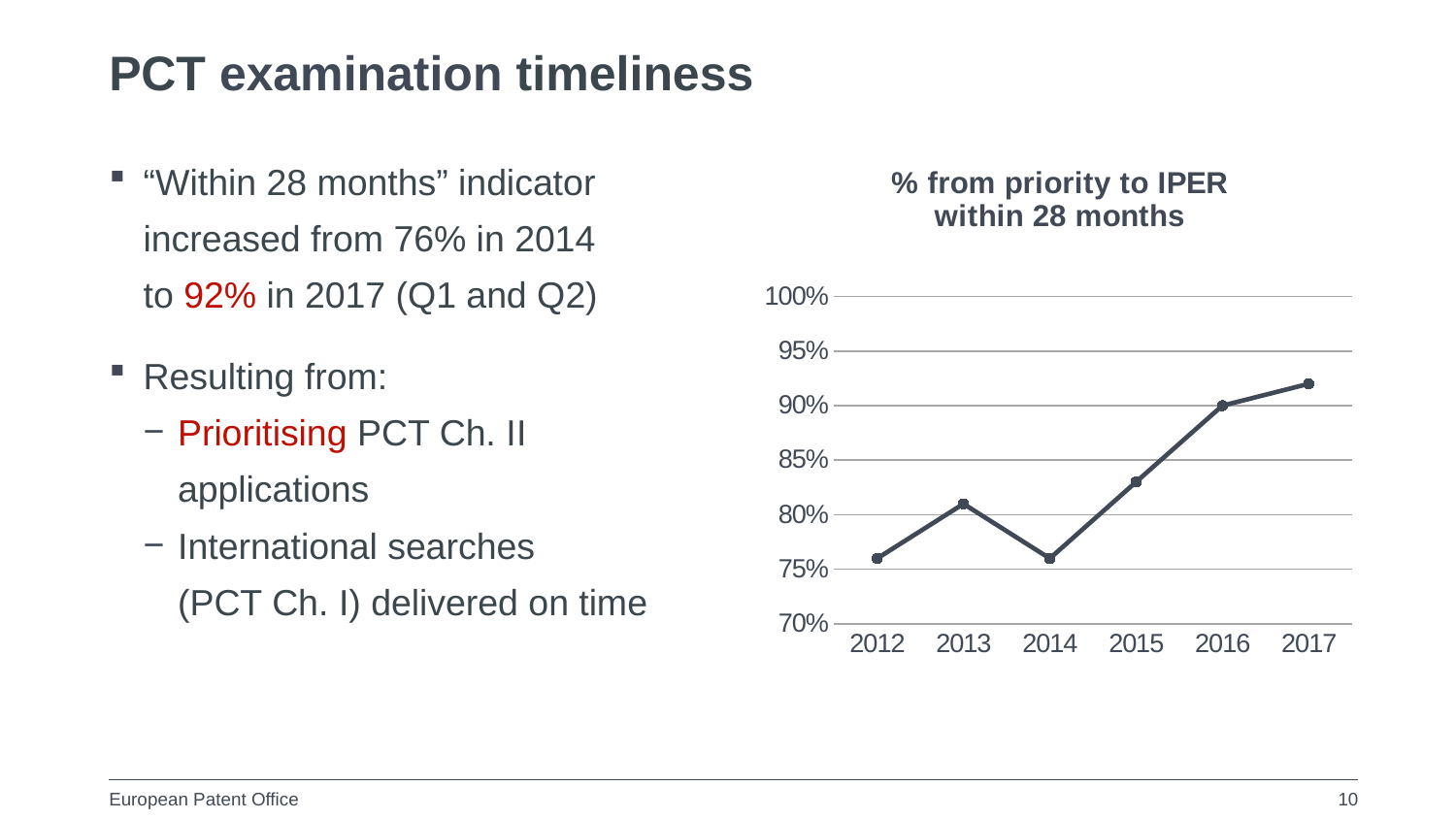
What is the title of the chart? % from priority to IPER within 28 months Which year has the larger value, 2013 or 2016? 2016 By how many percentage points did the indicator increase from 2014 to 2017? 16 Is the value for 2012 greater or less than 80%? less What is the value for 2017 in the chart? 92% What kind of chart is shown on the slide? line chart Which year has the highest value in the chart? 2017 What is the value for 2014 in the chart? 76% What is the value for 2016 in the chart? 90% How many years are plotted on the x axis of the chart? 6 Does the value generally rise or fall from 2014 to 2017? rise Is the value for 2015 greater or less than 80%? greater